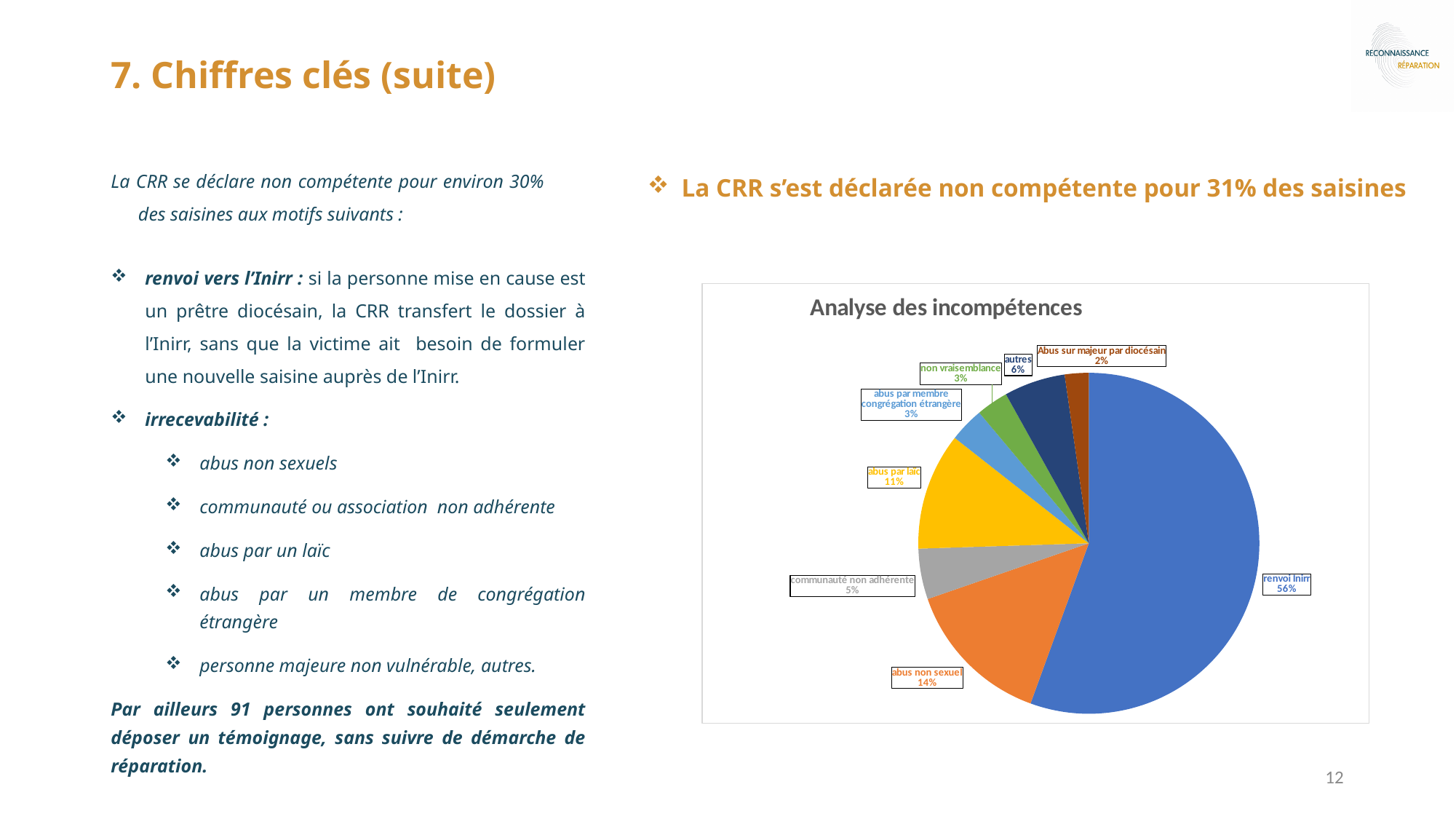
Which category has the largest slice of the pie? renvoi Inirr What share of the pie does "renvoi Inirr" represent? 56% What percentage is shown for "Abus sur majeur par diocésain"? 2% What percentage is shown for "abus non sexuel"? 14% What is the title of the chart? Analyse des incompétences What percentage is shown for "communauté non adhérente"? 5% Which category has the smallest slice of the pie? Abus sur majeur par diocésain What kind of chart is shown on the slide? pie chart Which is larger, the slice for "autres" or the slice for "communauté non adhérente"? autres What is the difference in percentage points between "renvoi Inirr" and "abus non sexuel"? 42 How many slices does the pie chart have? 8 What percentage is shown for "abus par laïc"? 11%